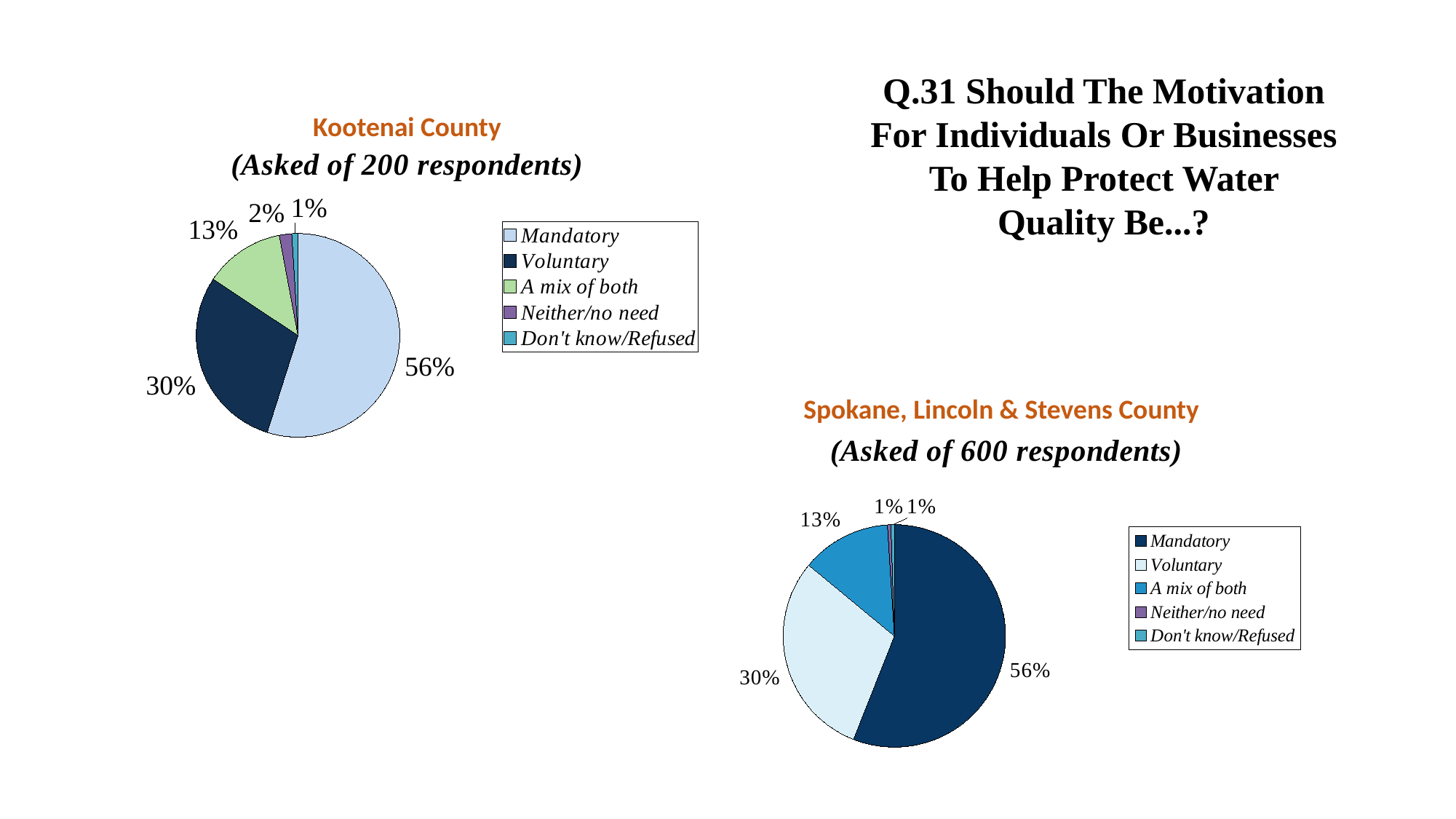
In the Kootenai County chart, what is the difference between the Mandatory and Voluntary shares? 26 percentage points In the Spokane, Lincoln & Stevens County chart, what share of respondents said Mandatory? 56% In the Kootenai County chart, what share of respondents said A mix of both? 13% In the Kootenai County chart, what share of respondents said Neither/no need? 2% In the Kootenai County chart, which category has the largest slice? Mandatory In the Spokane, Lincoln & Stevens County chart, what share of respondents said A mix of both? 13% In the Kootenai County chart, what share of respondents said Mandatory? 56% In the Kootenai County chart, what share of respondents said Voluntary? 30% How many entries does the legend of the Kootenai County chart list? 5 In the Spokane, Lincoln & Stevens County chart, which category has the smallest slice? Neither/no need and Don't know/Refused (both 1%) In the Spokane, Lincoln & Stevens County chart, which is larger, Voluntary or A mix of both? Voluntary What kind of chart is used for the Spokane, Lincoln & Stevens County data? Pie chart